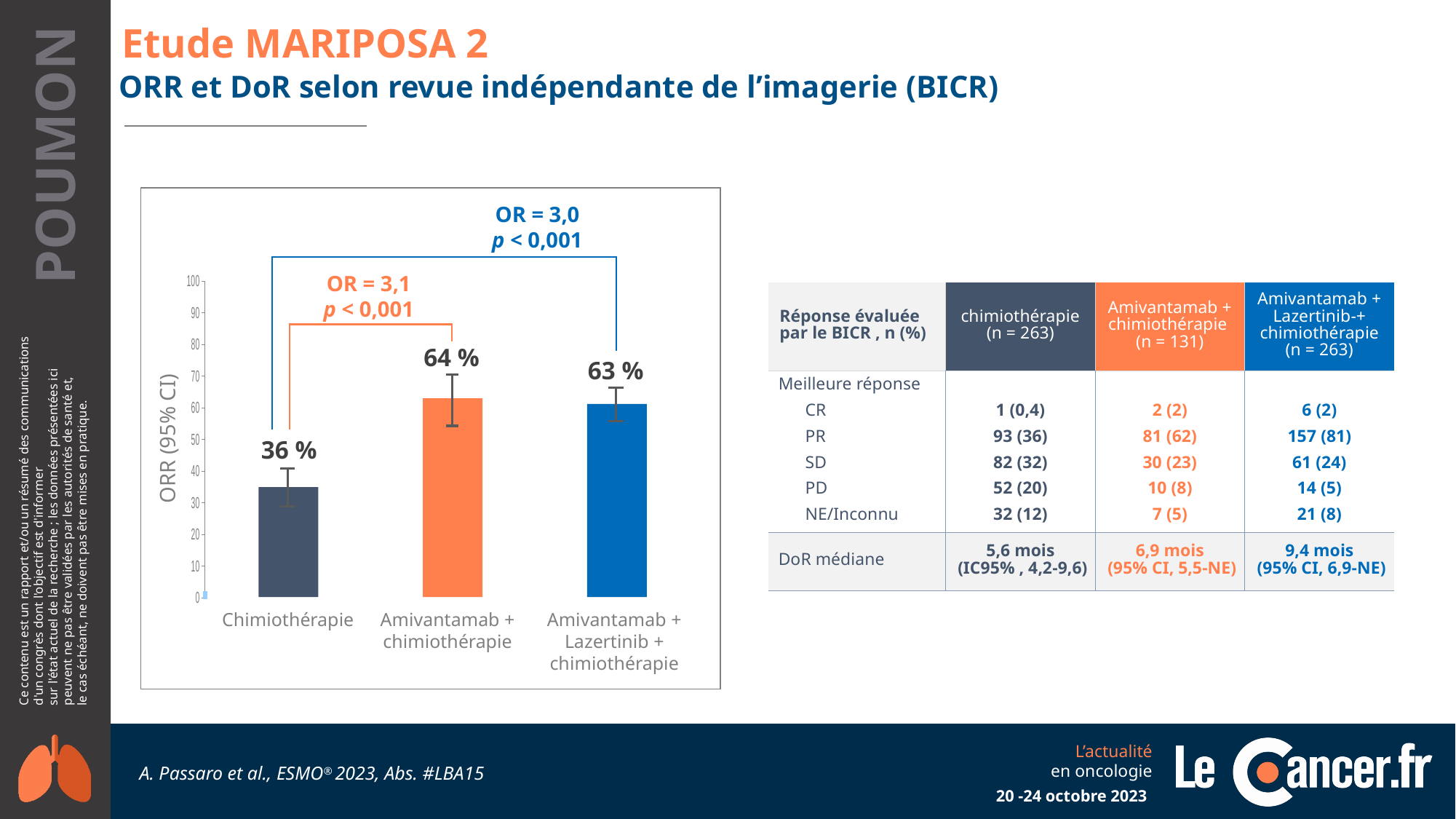
Which treatment arm has the highest ORR in the bar chart? Amivantamab + chimiothérapie How many treatment arms (bars) are shown in the bar chart? 3 Which treatment arm has the lowest ORR in the bar chart? Chimiothérapie What is the ORR value shown for Chimiothérapie? 36 % What is the label of the y axis of the bar chart? ORR (95% CI) Is the ORR value for Chimiothérapie greater or less than 40? less What is the difference in ORR between Amivantamab + Lazertinib + chimiothérapie and Chimiothérapie? 27 percentage points What is the difference in ORR between Amivantamab + chimiothérapie and Chimiothérapie? 28 percentage points What kind of chart is used to show the ORR results? Bar chart What is the ORR value shown for Amivantamab + Lazertinib + chimiothérapie? 63 % Which has a higher ORR: Chimiothérapie or Amivantamab + Lazertinib + chimiothérapie? Amivantamab + Lazertinib + chimiothérapie What is the ORR value shown for Amivantamab + chimiothérapie? 64 %